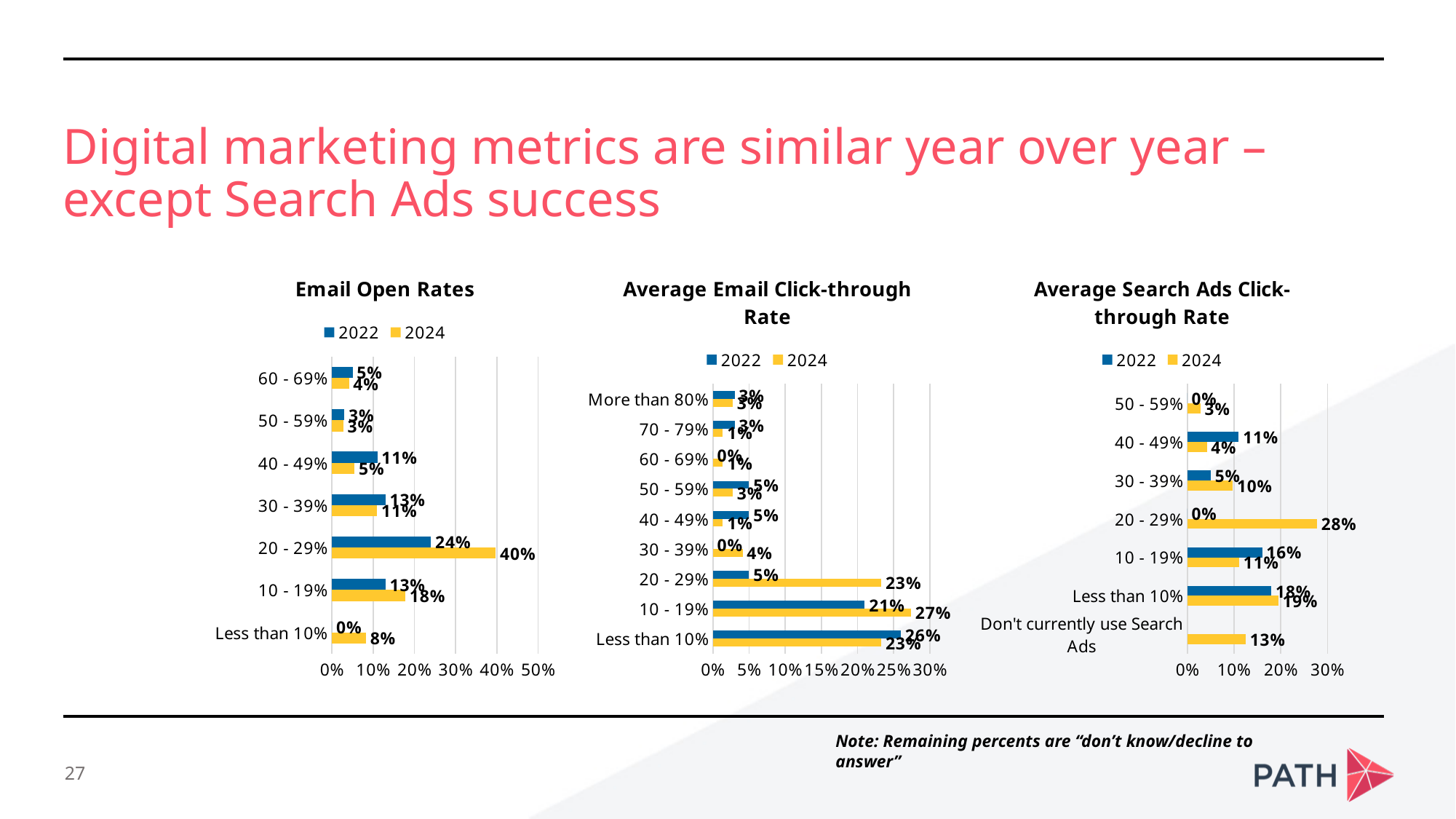
In the Email Open Rates chart, which category has the highest 2024 value? 20 - 29% In the Average Search Ads Click-through Rate chart, what is the 2024 value for the 20 - 29% category? 28% In the Email Open Rates chart, what is the difference between the 2024 and 2022 values for the 10 - 19% category? 5% In the Average Email Click-through Rate chart, how many categories are shown on the vertical axis? 9 In the Average Email Click-through Rate chart, which category has the highest 2022 value? Less than 10% In the Average Search Ads Click-through Rate chart, what is the 2024 value for 'Don't currently use Search Ads'? 13% In the Email Open Rates chart, what is the 2024 value for the 20 - 29% category? 40% What type of chart is the Average Search Ads Click-through Rate chart? Bar chart In the Average Search Ads Click-through Rate chart, which is larger for the 40 - 49% category, the 2022 value or the 2024 value? 2022 In the Email Open Rates chart, what is the 2022 value for the 40 - 49% category? 11% In the Average Email Click-through Rate chart, what is the 2024 value for the 20 - 29% category? 23% How many series does the legend of the Email Open Rates chart list? 2